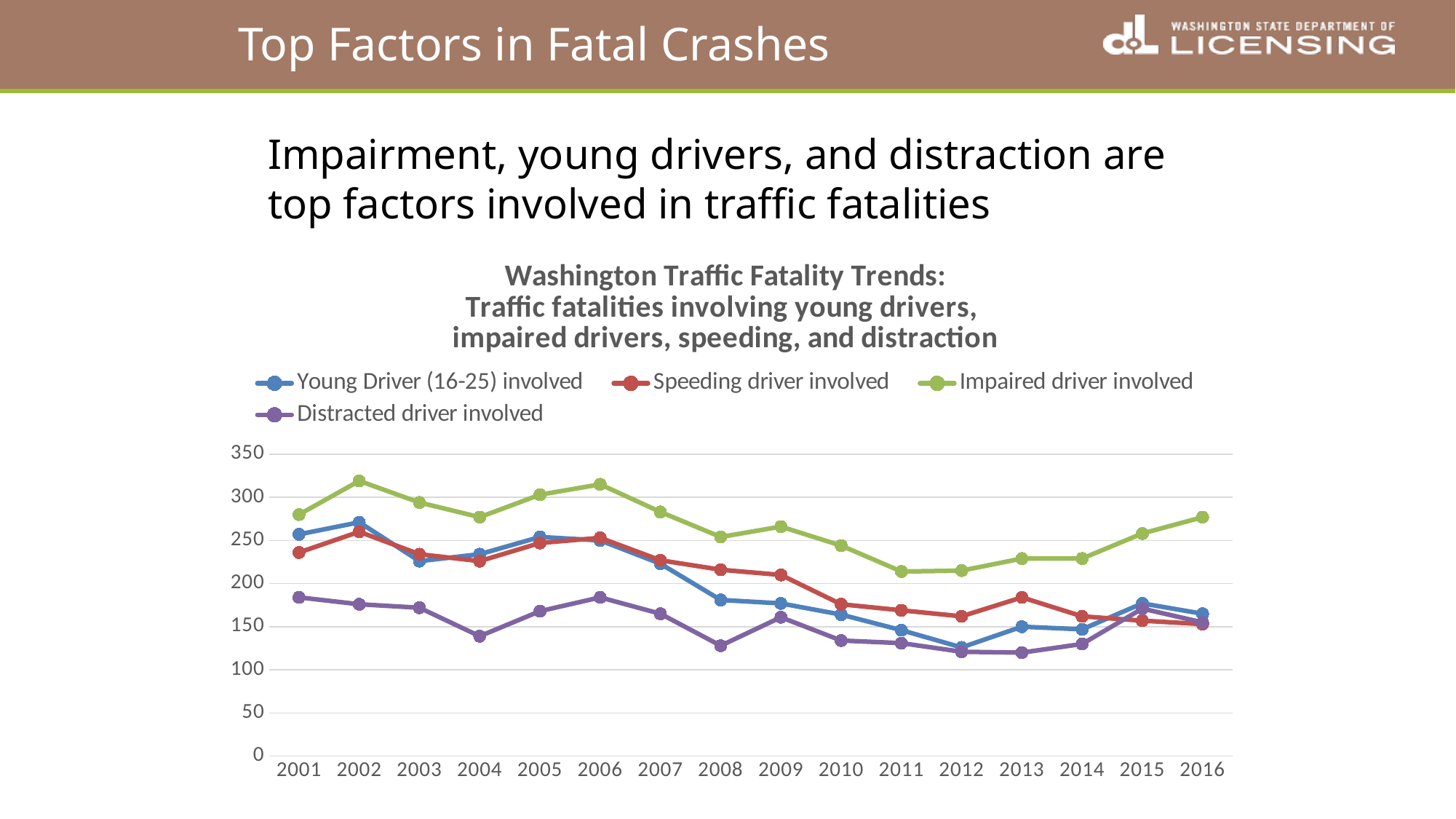
What colour is the line for Impaired driver involved? green What kind of chart is shown on the slide? line chart Do the values for Young Driver (16-25) involved rise or fall from 2006 to 2012? fall How many years are shown on the x axis? 16 In 2008, which is larger: Speeding driver involved or Young Driver (16-25) involved? Speeding driver involved In 2015, which is larger: Young Driver (16-25) involved or Speeding driver involved? Young Driver (16-25) involved Which series has the highest value in 2016? Impaired driver involved Is the value for Impaired driver involved in 2002 greater or less than 300? greater How many series does the legend list? 4 Is the value for Speeding driver involved in 2001 greater or less than 200? greater In which year is the value for Young Driver (16-25) involved lowest? 2012 Is the value for Distracted driver involved in 2012 greater or less than 150? less